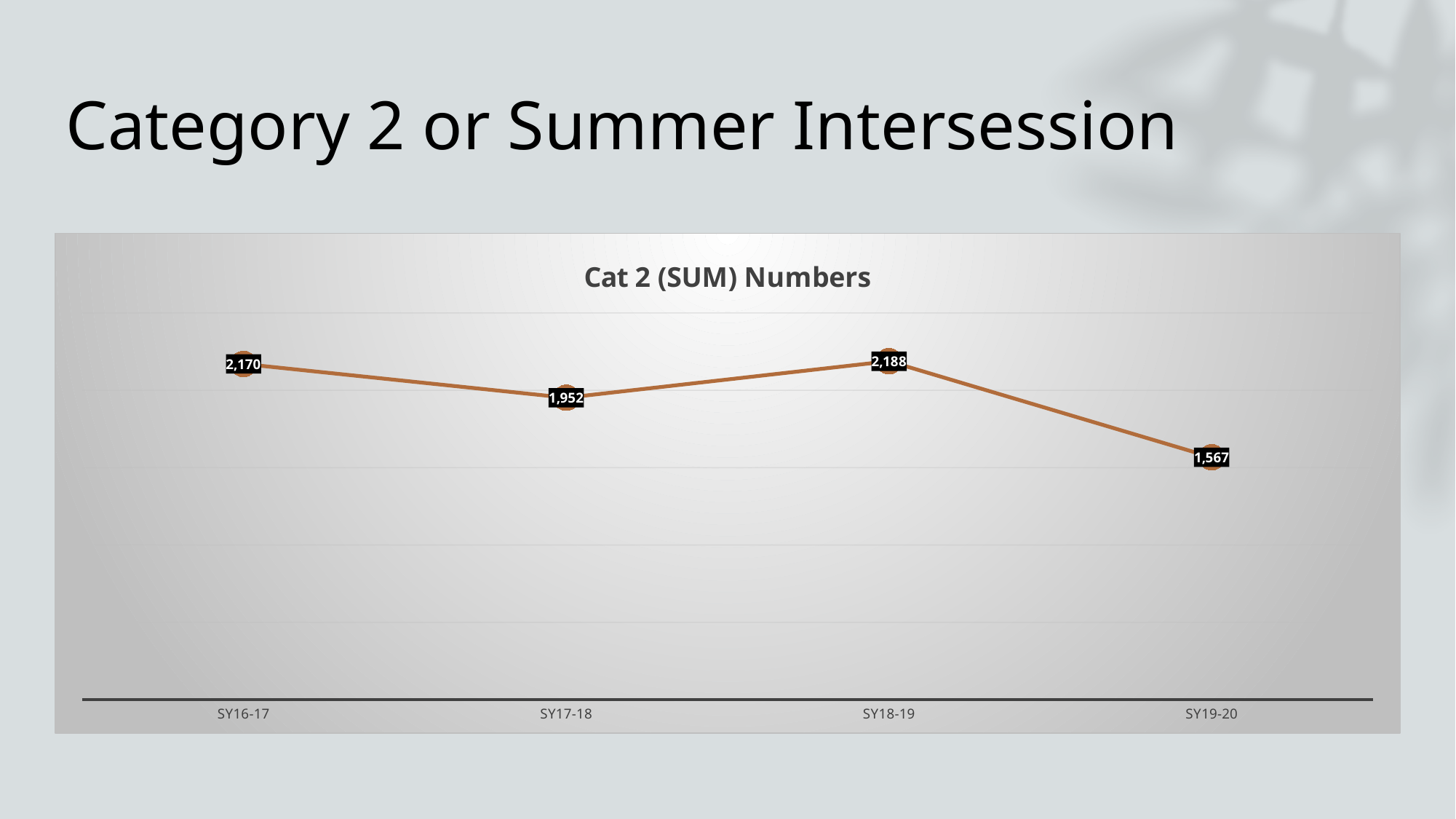
What is the value for SY18-19? 2,188 What kind of chart is shown on the slide? Line chart What is the title of the chart? Cat 2 (SUM) Numbers What is the value for SY17-18? 1,952 What is the value for SY19-20? 1,567 What is the value for SY16-17? 2,170 Which school year has the lowest value? SY19-20 What is the difference between the values for SY16-17 and SY17-18? 218 What is the difference between the values for SY18-19 and SY19-20? 621 Which school year has the highest value? SY18-19 How many school years are plotted on the chart? 4 Which is larger, the value for SY17-18 or the value for SY19-20? SY17-18